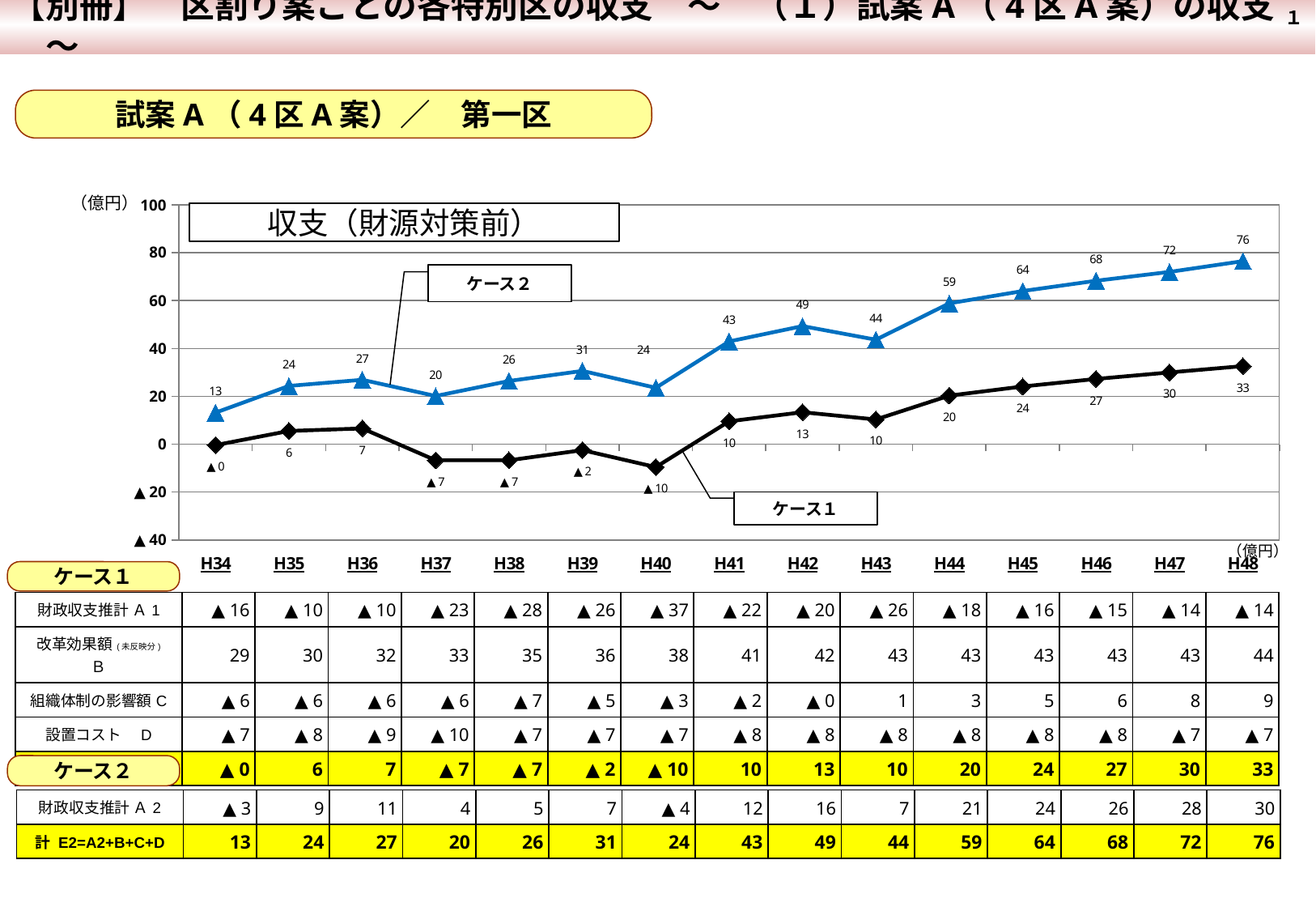
What is the title of the chart? 収支（財源対策前） Which series has the larger value at H41, ケース1 or ケース2? ケース2 How many series are plotted in the chart? 2 What kind of chart is shown on the slide? line chart What is the value of ケース2 at H48 in the chart 収支（財源対策前）? 76 What is the value of ケース1 at H44? 20 What is the difference between ケース2 and ケース1 at H48? 43 How many years are plotted on the x axis of the chart? 15 At which year does ケース2 reach its highest value? H48 What is the value of ケース2 at H42? 49 At which year does ケース1 reach its lowest value? H40 What is the value of ケース1 at H40 in the chart? ▲10